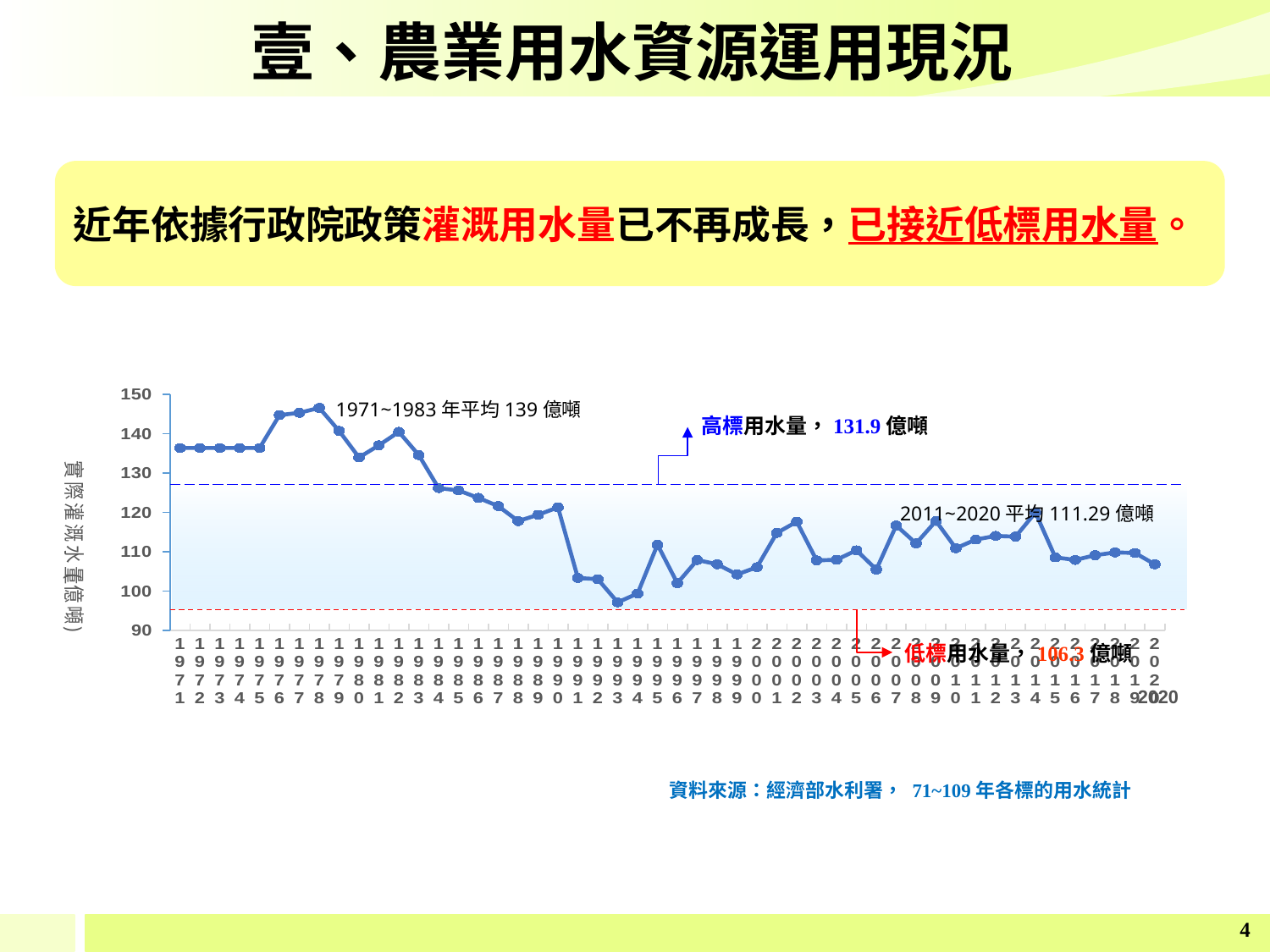
According to the annotation on the chart, what is the average irrigation water volume for 2011~2020? 111.29 億噸 Is the value for 1993 greater or less than 100? less According to the annotation on the chart, what is the average irrigation water volume for 1971~1983? 139 億噸 According to the annotation on the chart, what is the 高標用水量? 131.9 億噸 What is the first year shown on the x axis of the chart? 1971 Is the value for 1984 greater or less than 130? less Is the value for 1978 greater or less than 140? greater How many years (data points) are plotted along the x axis of the chart? 50 Which is larger, the value for 1971 or the value for 2020? 1971 Which year has the lowest plotted value on the chart? 1993 What kind of chart is shown on the slide? line chart